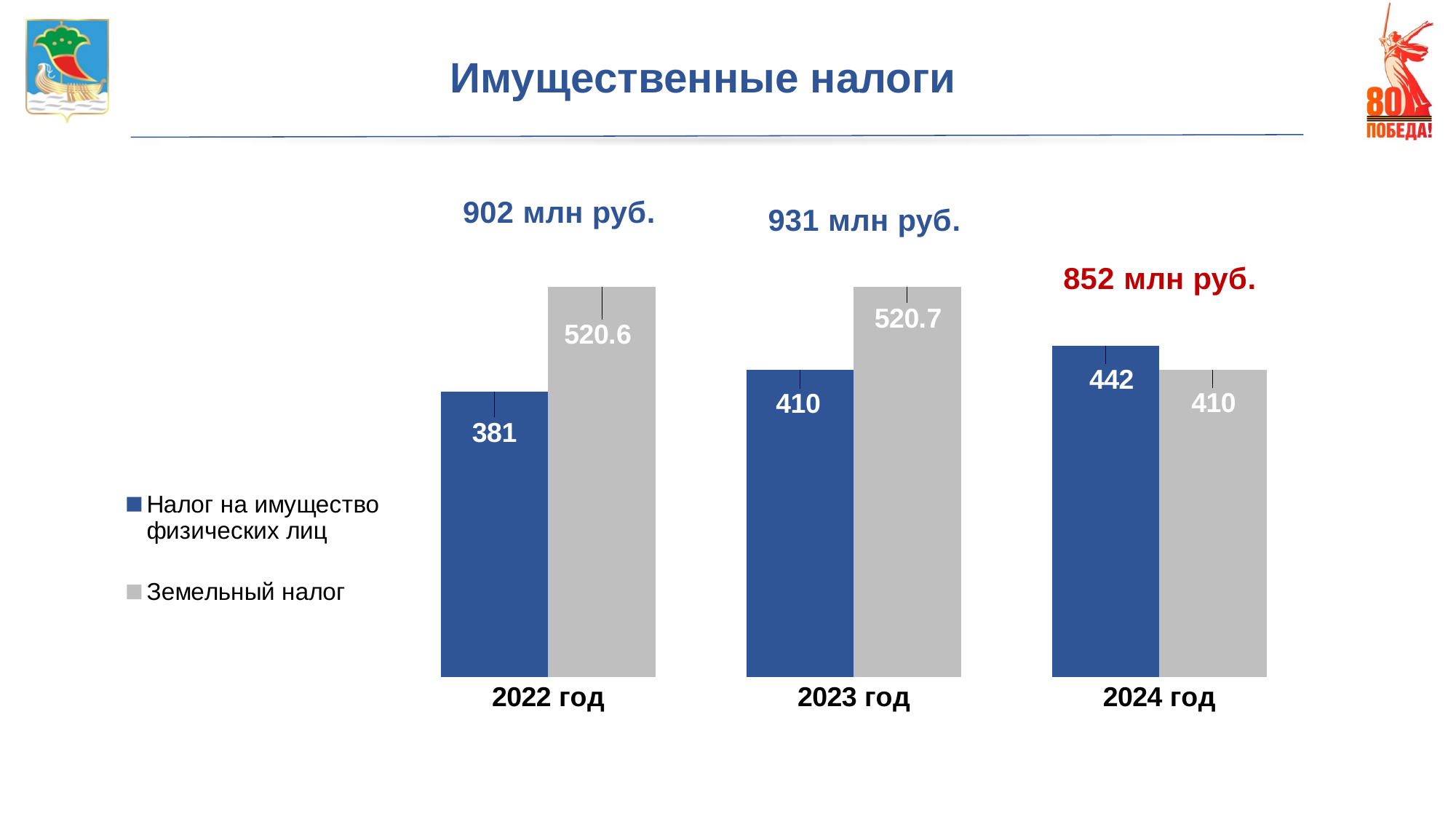
What is the value of Земельный налог for 2023 год? 520.7 What kind of chart is shown on the slide? bar chart How many series does the legend list? 2 What total is printed above the bars for 2024 год? 852 млн руб. What is the value of Налог на имущество физических лиц for 2022 год? 381 How many years are shown on the x axis? 3 Which is larger in 2024 год: Налог на имущество физических лиц or Земельный налог? Налог на имущество физических лиц Does Налог на имущество физических лиц rise or fall from 2022 год to 2024 год? rise In which year is Налог на имущество физических лиц highest? 2024 год What is the value of Земельный налог for 2024 год? 410 What is the difference between Земельный налог and Налог на имущество физических лиц in 2022 год? 139.6 In which year is Земельный налог lowest? 2024 год